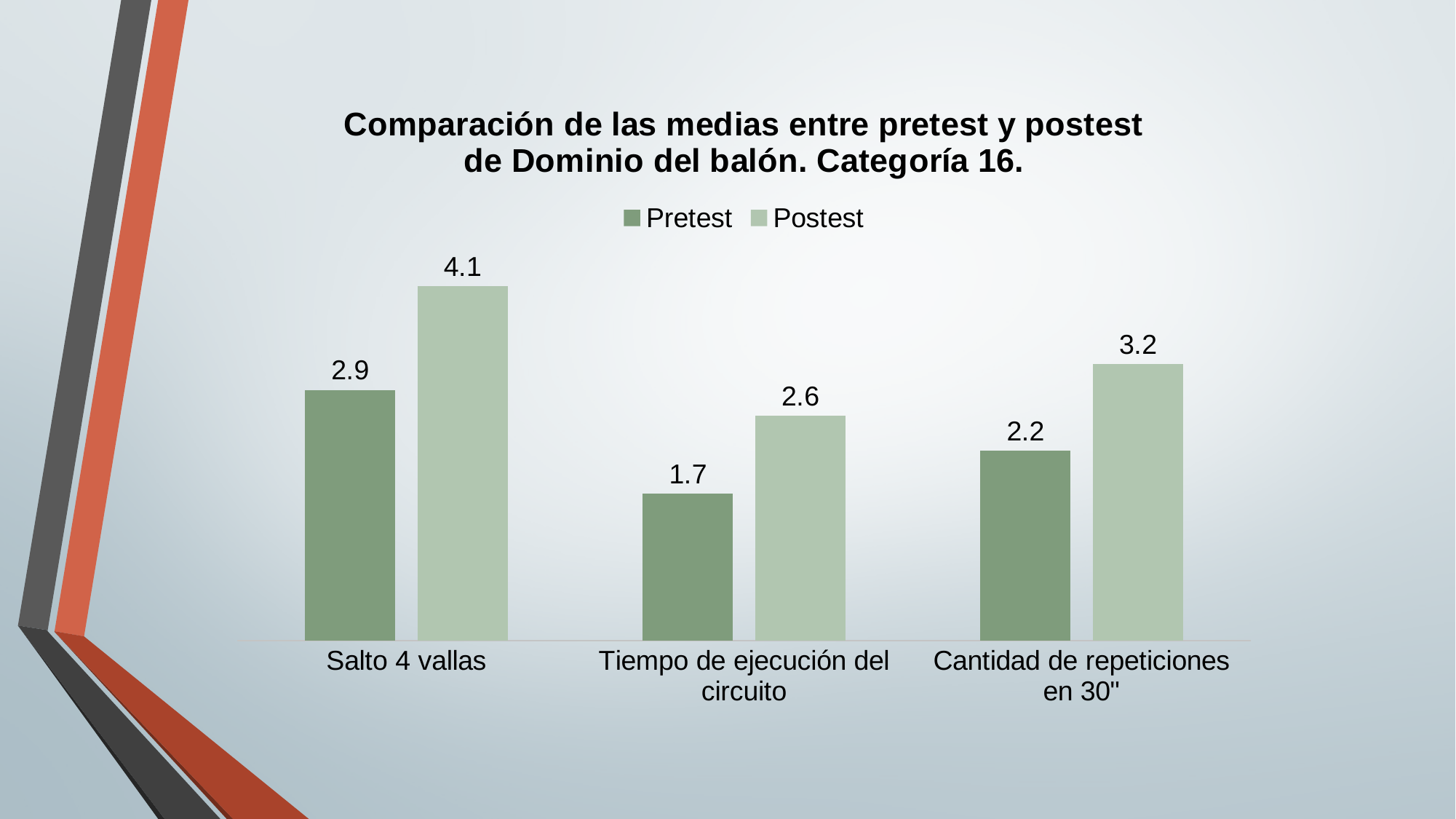
What is the Pretest value for Salto 4 vallas? 2.9 What is the difference between the Postest and Pretest values for Cantidad de repeticiones en 30"? 1.0 What is the Pretest value for Tiempo de ejecución del circuito? 1.7 Which category has the highest Postest value? Salto 4 vallas How many series does the legend list? 2 What is the Postest value for Cantidad de repeticiones en 30"? 3.2 Which is larger for Tiempo de ejecución del circuito, the Pretest or the Postest value? Postest What is the difference between the Postest and Pretest values for Salto 4 vallas? 1.2 Which category has the lowest Pretest value? Tiempo de ejecución del circuito How many categories are shown on the x axis? 3 What kind of chart is shown on the slide? Bar chart What is the Postest value for Salto 4 vallas? 4.1